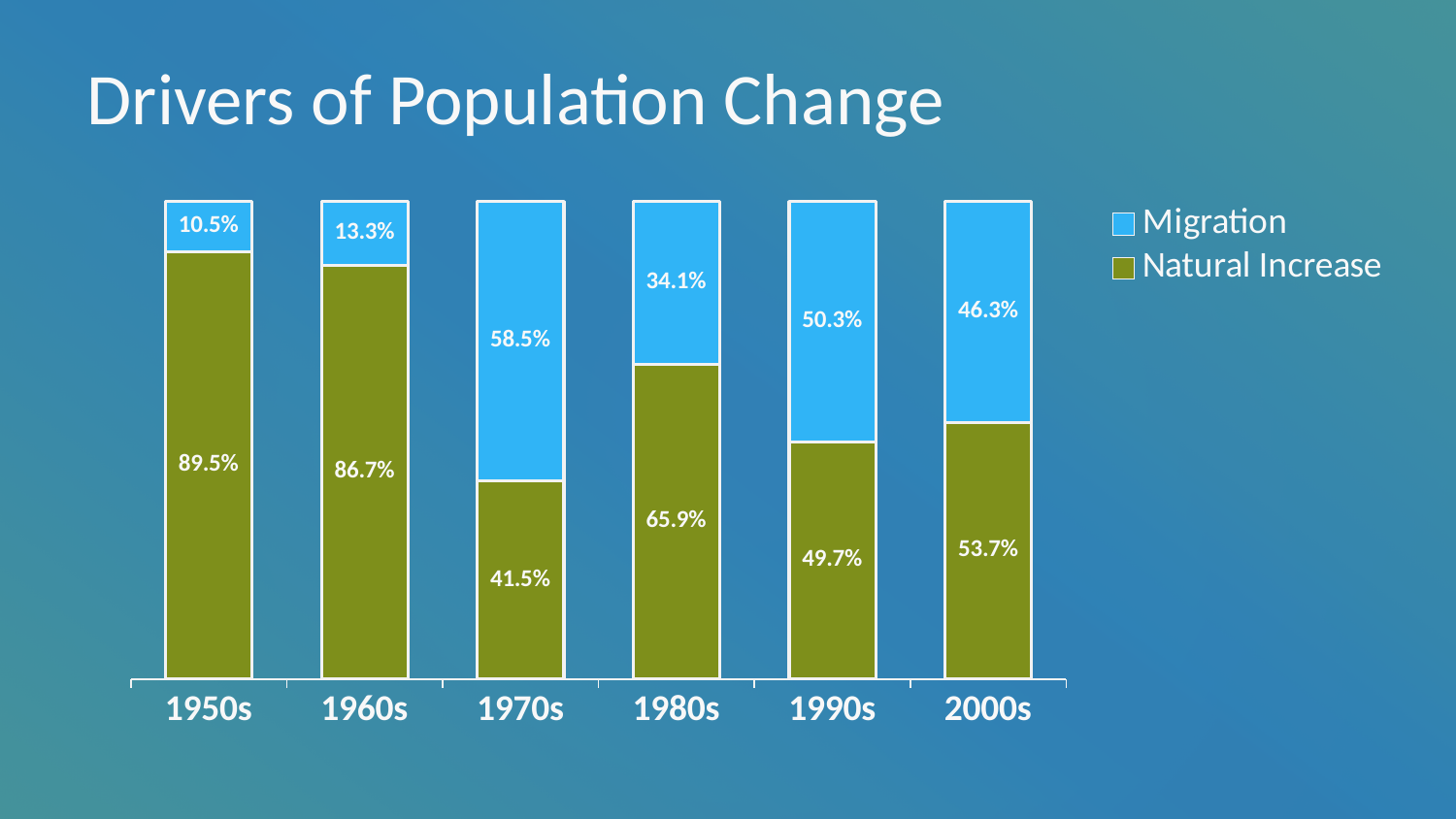
What is the difference between the Natural Increase share in the 1960s and the 1980s? 20.8% How many series does the legend list? 2 How many decades are shown on the x axis? 6 What kind of chart is shown on the slide? Stacked bar chart Which decade has the lowest Natural Increase share? 1970s What is the Migration share for the 2000s? 46.3% Which is larger in the 1990s, Migration or Natural Increase? Migration Which decade has the highest Migration share? 1970s What is the Migration share for the 1970s? 58.5% Does the Migration share rise or fall from the 1950s to the 1970s? Rise What is the Natural Increase share for the 1950s? 89.5% What is the title of the chart? Drivers of Population Change